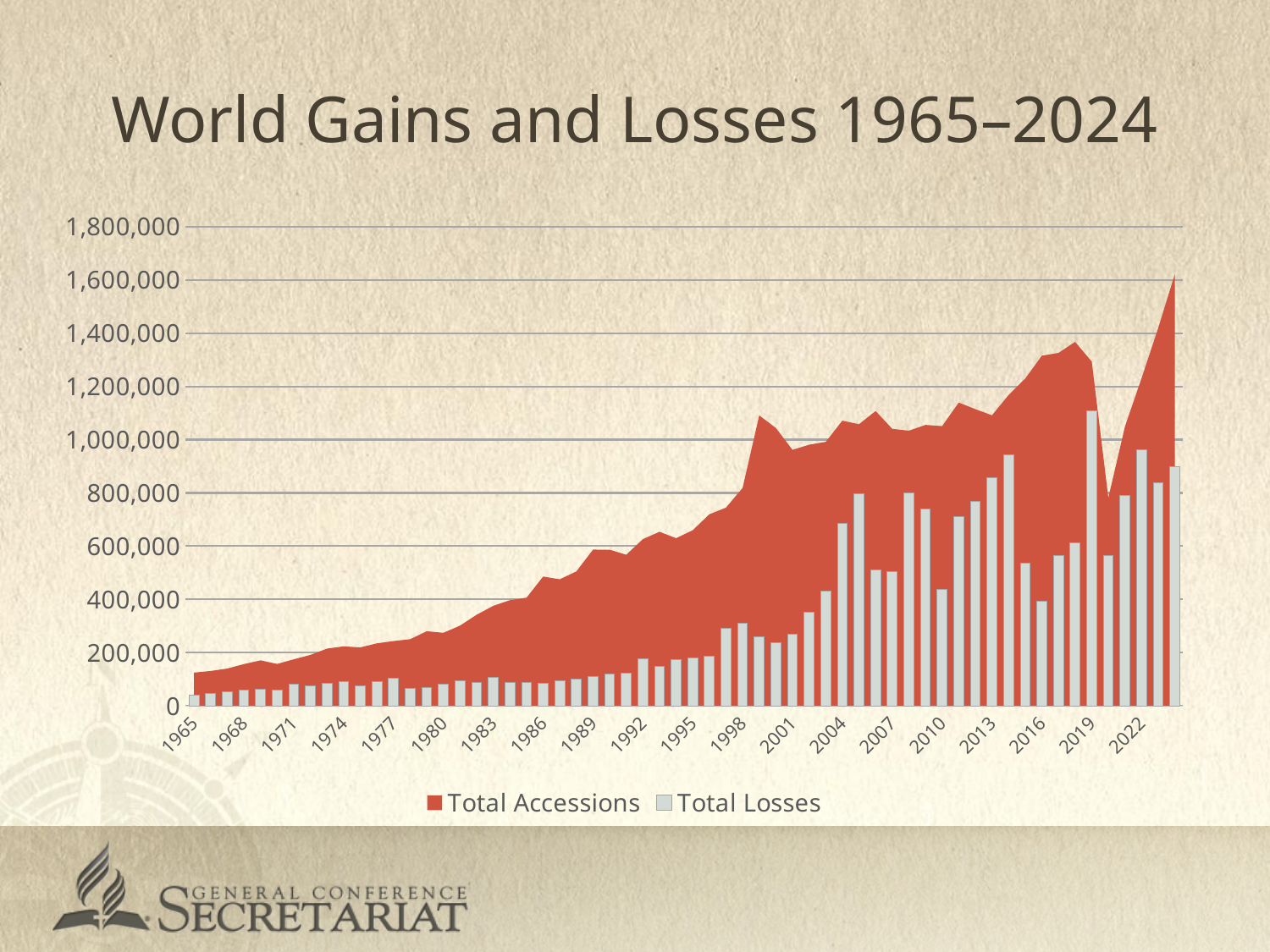
Which series is shown as grey bars? Total Losses Which is larger in 2024, Total Accessions or Total Losses? Total Accessions Is the value for Total Accessions in 2024 greater or less than 1,400,000? greater Is the value for Total Accessions in 2020 greater or less than 1,000,000? less Is the value for Total Losses in 2019 greater or less than 1,000,000? greater What is the title of the chart? World Gains and Losses 1965–2024 In which year is Total Losses highest? 2019 In which year is Total Accessions highest? 2024 How many series does the legend list? 2 What is the highest value shown on the vertical axis? 1,800,000 Do Total Accessions generally rise or fall from 1965 to 2024? rise